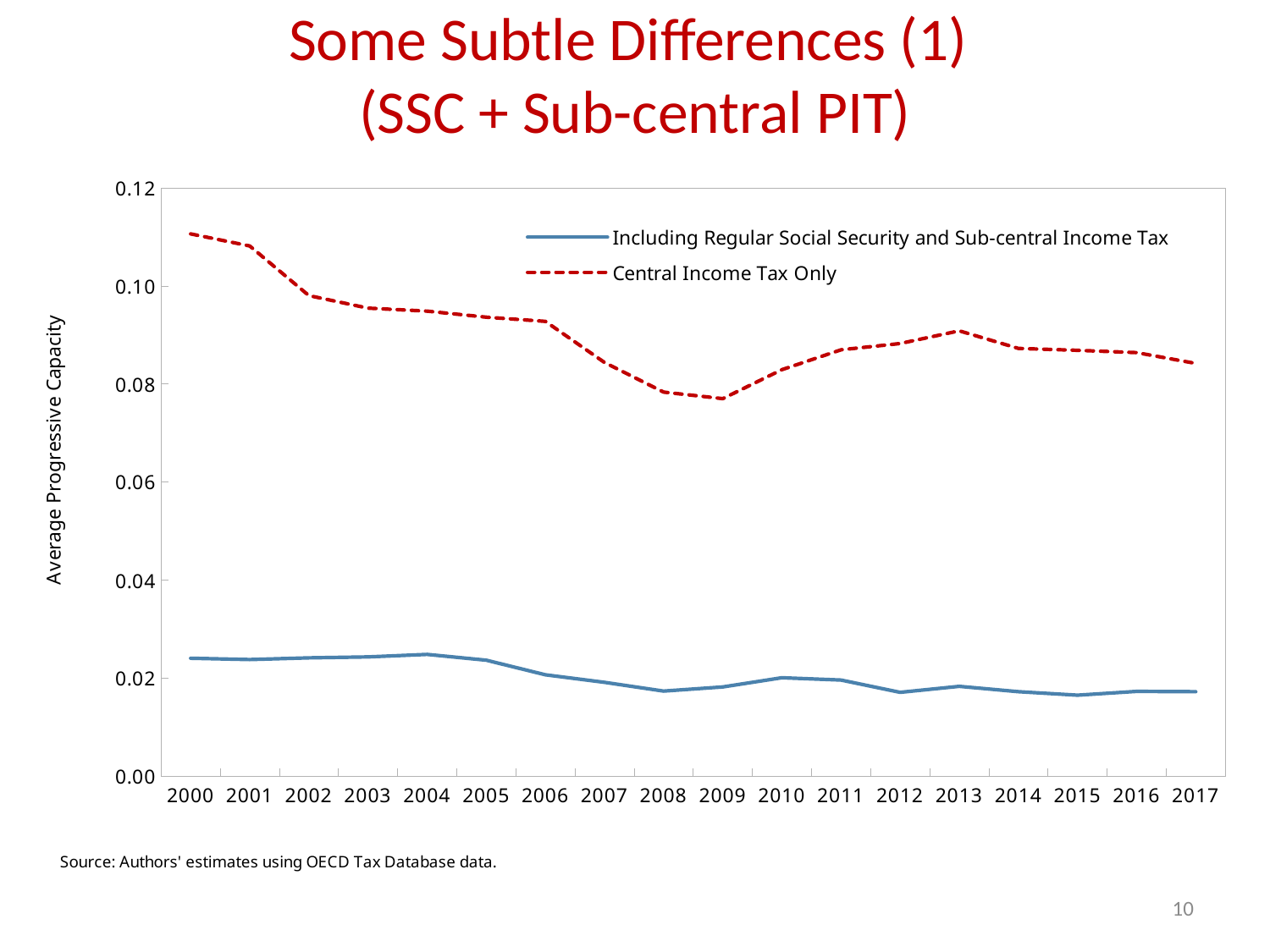
In 2010, which series has the larger value: Central Income Tax Only or Including Regular Social Security and Sub-central Income Tax? Central Income Tax Only Is the value for Including Regular Social Security and Sub-central Income Tax in 2004 greater or less than 0.02? greater What is the label on the y axis? Average Progressive Capacity Is the value for Including Regular Social Security and Sub-central Income Tax in 2008 greater or less than 0.02? less Is the value for Central Income Tax Only in 2013 greater or less than 0.08? greater In which year is the Central Income Tax Only series at its highest? 2000 What kind of chart is shown on the slide? line chart Does the Central Income Tax Only series rise or fall from 2000 to 2009? fall How many series does the legend list? 2 How many years are plotted along the x axis? 18